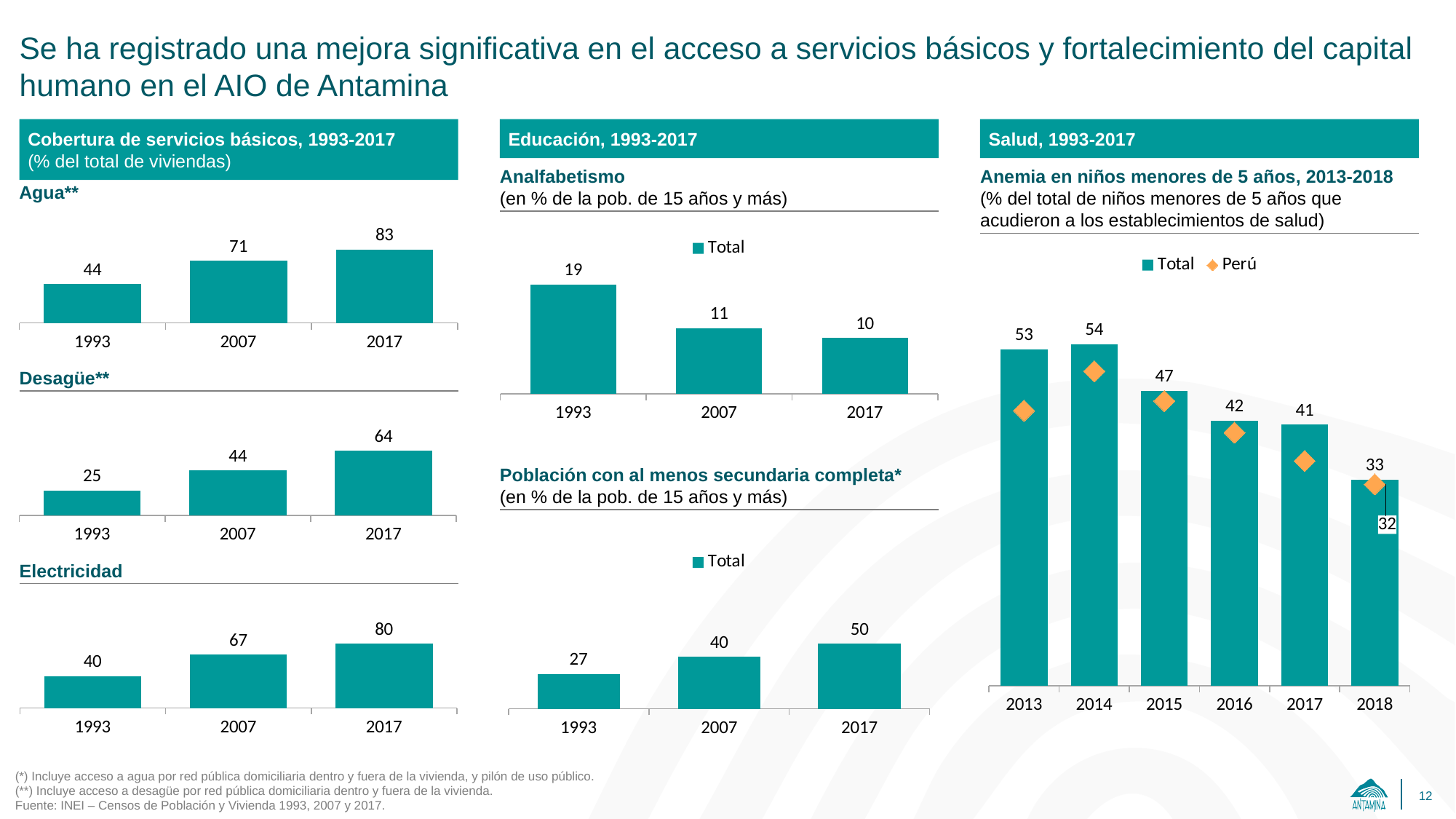
In the Anemia en niños menores de 5 años chart, what is the Perú value for 2018? 32 In the Analfabetismo chart, do the values rise or fall from 1993 to 2017? fall In the Agua chart, what is the value for 2017? 83 In the Anemia en niños menores de 5 años chart, how many series does the legend list? 2 In the Analfabetismo chart, which year has the highest value? 1993 In the Anemia en niños menores de 5 años chart, which year has the lowest Total value? 2018 In the Población con al menos secundaria completa chart, how many years are shown on the x axis? 3 In the Desagüe chart, what is the value for 1993? 25 In the Electricidad chart, what is the difference between the 2017 and 1993 values? 40 In the Anemia en niños menores de 5 años chart, what is the Total value for 2014? 54 In the Población con al menos secundaria completa chart, what is the value for 2007? 40 What kind of chart is the Agua chart? bar chart